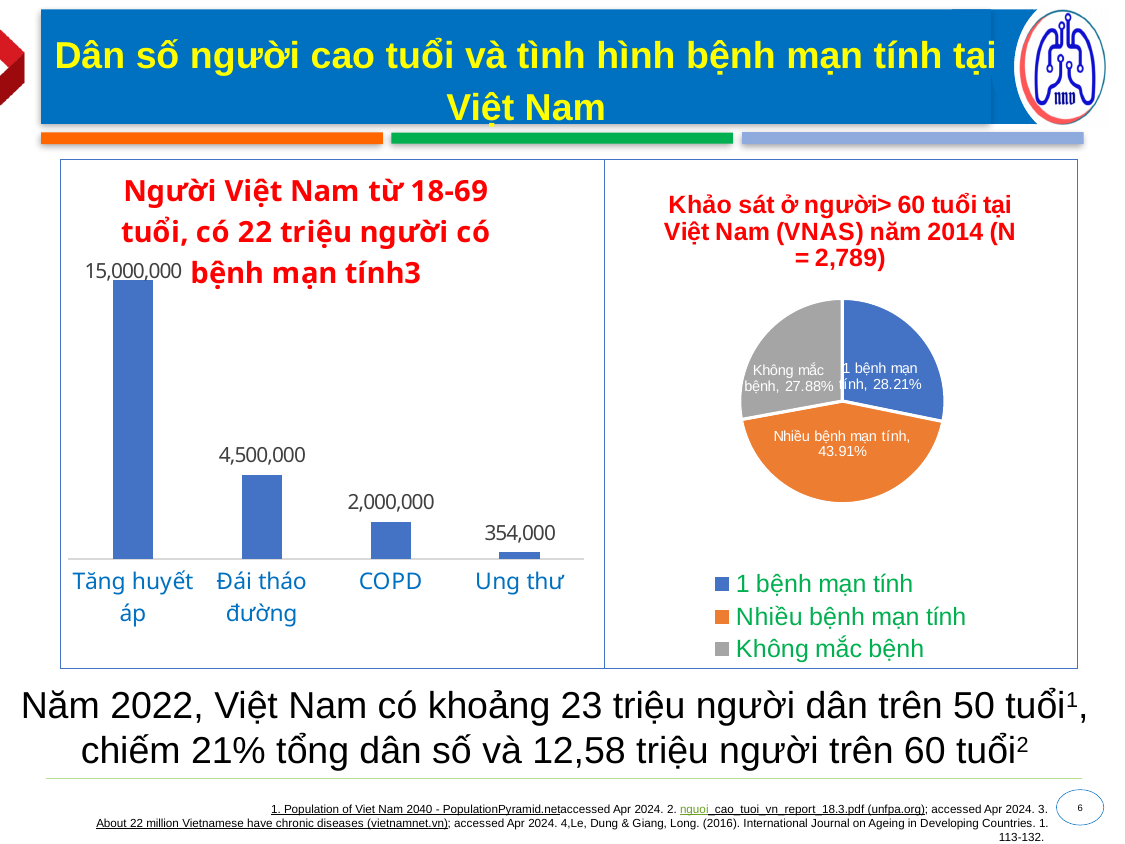
In the bar chart on the left, what is the value for Ung thư? 354,000 In the pie chart on the right, what share is labelled Nhiều bệnh mạn tính? 43.91% How many categories are shown in the bar chart on the left? 4 In the bar chart on the left, which category has the lowest value? Ung thư In the bar chart on the left, what is the value for COPD? 2,000,000 In the pie chart on the right, which slice is the largest? Nhiều bệnh mạn tính In the bar chart on the left, what is the difference between Đái tháo đường and COPD? 2,500,000 How many entries does the legend of the pie chart on the right list? 3 In the bar chart on the left, what is the value for Tăng huyết áp? 15,000,000 In the bar chart on the left, which category has the highest value? Tăng huyết áp In the bar chart on the left, which is larger: Đái tháo đường or COPD? Đái tháo đường What type of chart is on the left side of the slide? Bar chart